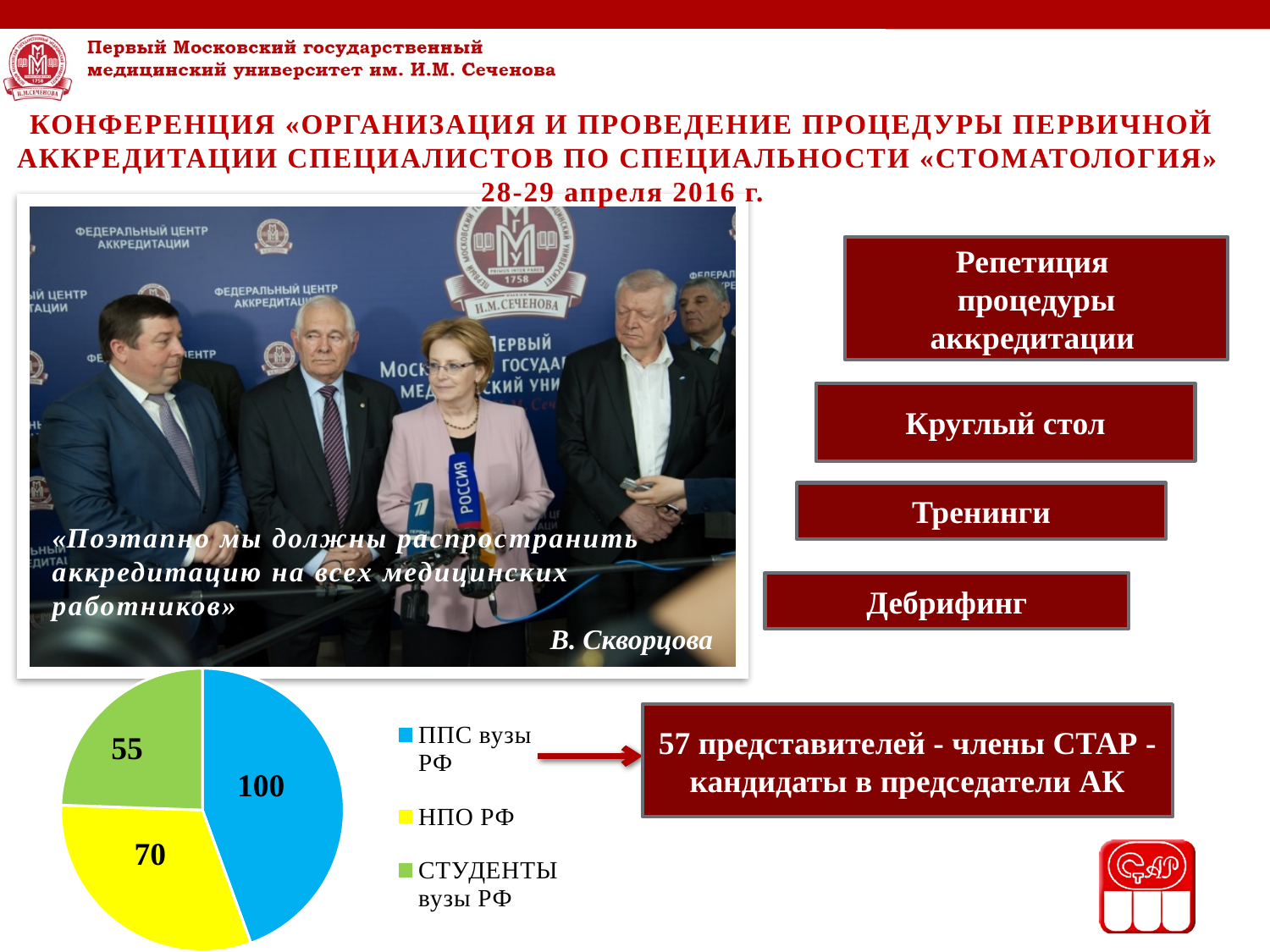
How many slices does the pie chart have? 3 Which category has the smallest slice in the pie chart? СТУДЕНТЫ вузы РФ What colour is the slice for НПО РФ in the pie chart? yellow What is the value for ППС вузы РФ in the pie chart? 100 Which category has the largest slice in the pie chart? ППС вузы РФ What is the difference between the values for ППС вузы РФ and НПО РФ in the pie chart? 30 What is the difference between the values for НПО РФ and СТУДЕНТЫ вузы РФ in the pie chart? 15 What kind of chart is shown at the bottom left of the slide? pie chart Which is larger in the pie chart: НПО РФ or СТУДЕНТЫ вузы РФ? НПО РФ What is the value for НПО РФ in the pie chart? 70 How many entries does the legend of the pie chart list? 3 What is the value for СТУДЕНТЫ вузы РФ in the pie chart? 55